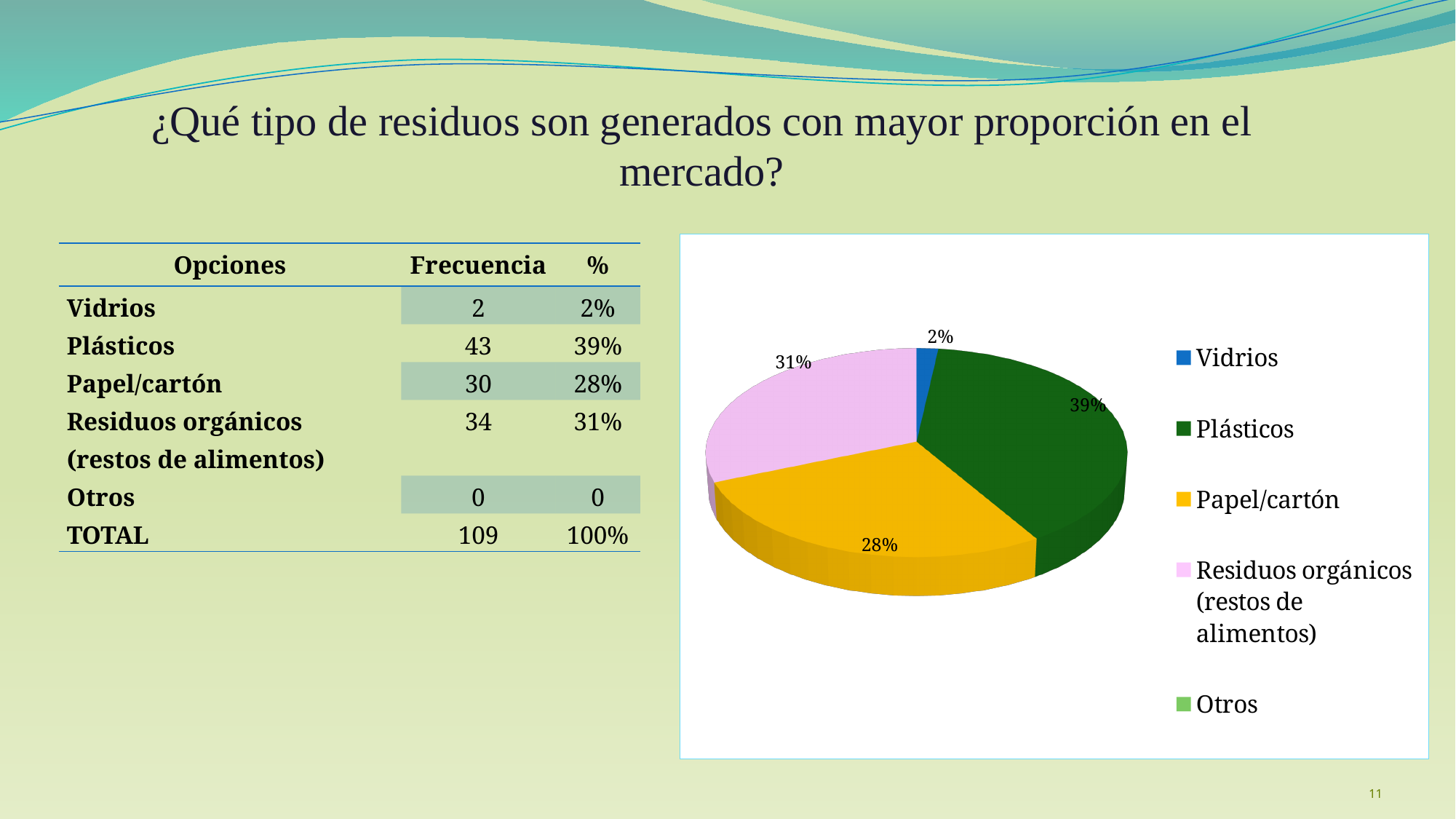
Which category with a visible slice has the smallest share of the pie? Vidrios What share of the pie does Vidrios represent? 2% Which legend entry is shown in dark green? Plásticos What is the difference in percentage points between the Plásticos slice and the Papel/cartón slice? 11% Which category has the largest slice of the pie? Plásticos What share of the pie does Plásticos represent? 39% What colour is the Papel/cartón slice in the pie chart? Yellow What kind of chart is shown on the slide? Pie chart What share of the pie does Papel/cartón represent? 28% How many entries does the legend of the pie chart list? 5 Which slice is larger, Residuos orgánicos (restos de alimentos) or Papel/cartón? Residuos orgánicos (restos de alimentos)